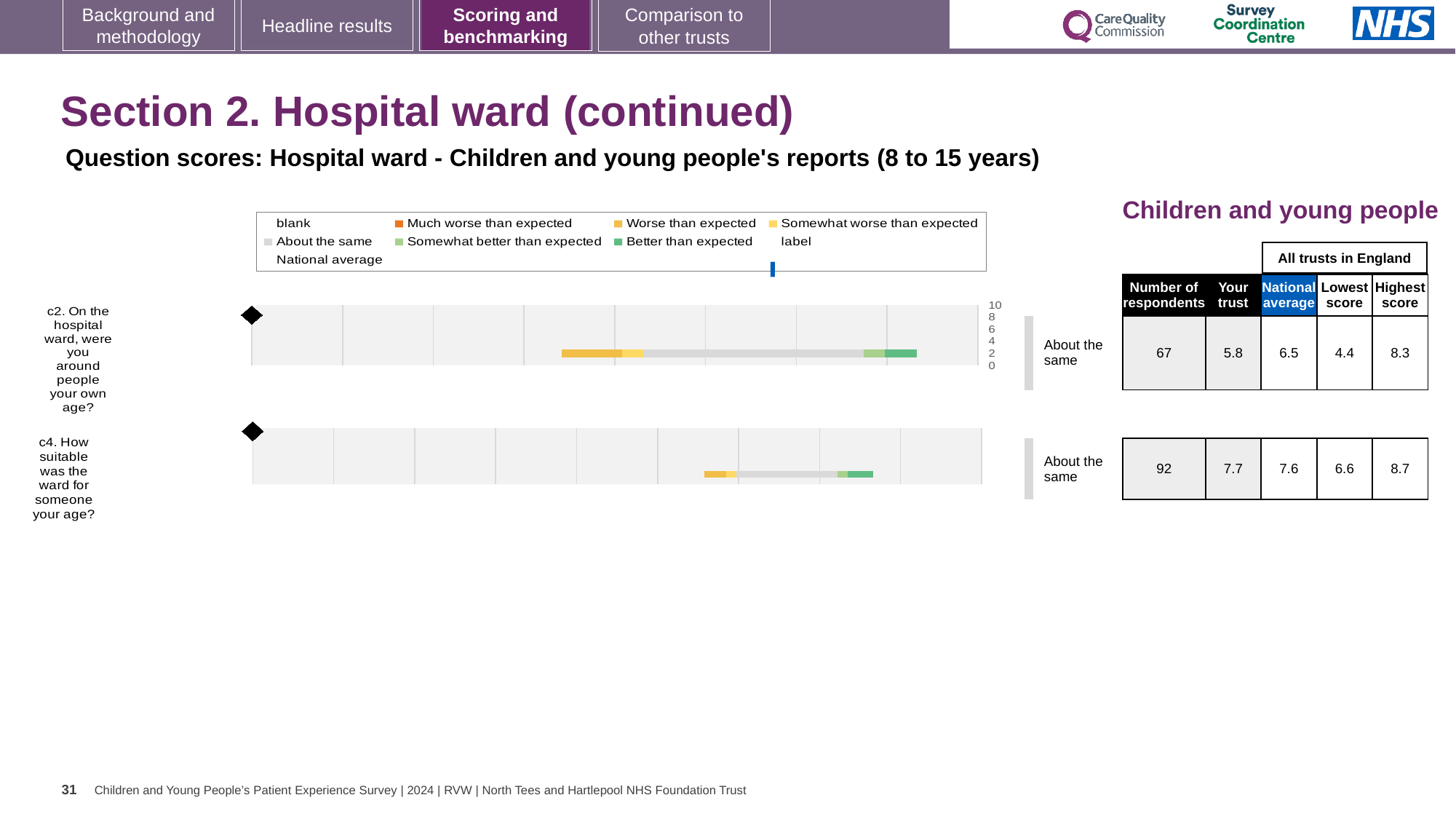
What colour does the legend use for 'Better than expected'? Green What kind of chart is used to show the question scores on this slide? Bar chart What is the lowest score among all trusts in England for question c4? 6.6 What is the difference between the 'Your trust' score and the national average for question c4? 0.1 Is the 'Your trust' score for question c4 greater or less than 6? greater Which question has the higher 'Your trust' score, c2 or c4? c4 How many questions are plotted in the chart on this slide? 2 What benchmark category is shown for question c2? About the same What is the difference between the highest score and the lowest score for question c2? 3.9 How many respondents answered question c2? 67 What is the national average score for question c4 (How suitable was the ward for someone your age?)? 7.6 What is the 'Your trust' score for question c2 (On the hospital ward, were you around people your own age?)? 5.8